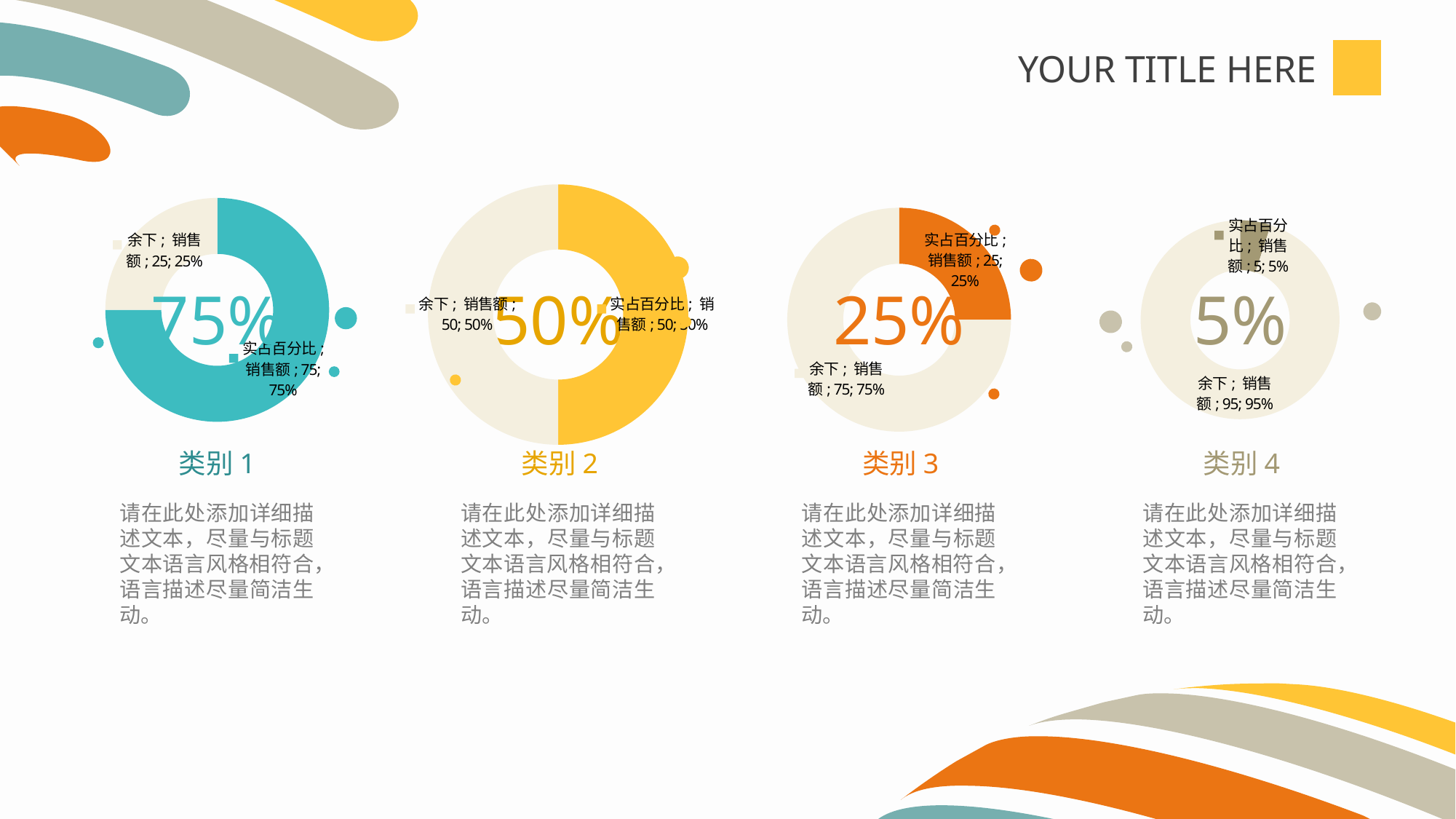
In the second doughnut chart from the left (above 类别 2), what is the value for 余下? 50 In the leftmost doughnut chart (above 类别 1), which slice is the largest? 实占百分比 How many slices does the third doughnut chart from the left (above 类别 3) have? 2 What type of chart is shown above 类别 2? Doughnut chart In the second doughnut chart from the left (above 类别 2), what share of the chart does the 实占百分比 slice take? 50% In the rightmost doughnut chart (above 类别 4), what share of the chart does the 余下 slice take? 95% How many doughnut charts are shown on the slide? 4 In the leftmost doughnut chart (above 类别 1), what is the value for 实占百分比? 75 In the third doughnut chart from the left (above 类别 3), which slice is larger, 实占百分比 or 余下? 余下 In the leftmost doughnut chart (above 类别 1), what share of the chart does the 余下 slice take? 25% In the third doughnut chart from the left (above 类别 3), what is the value for 实占百分比? 25 In the rightmost doughnut chart (above 类别 4), what is the difference between the 余下 value and the 实占百分比 value? 90